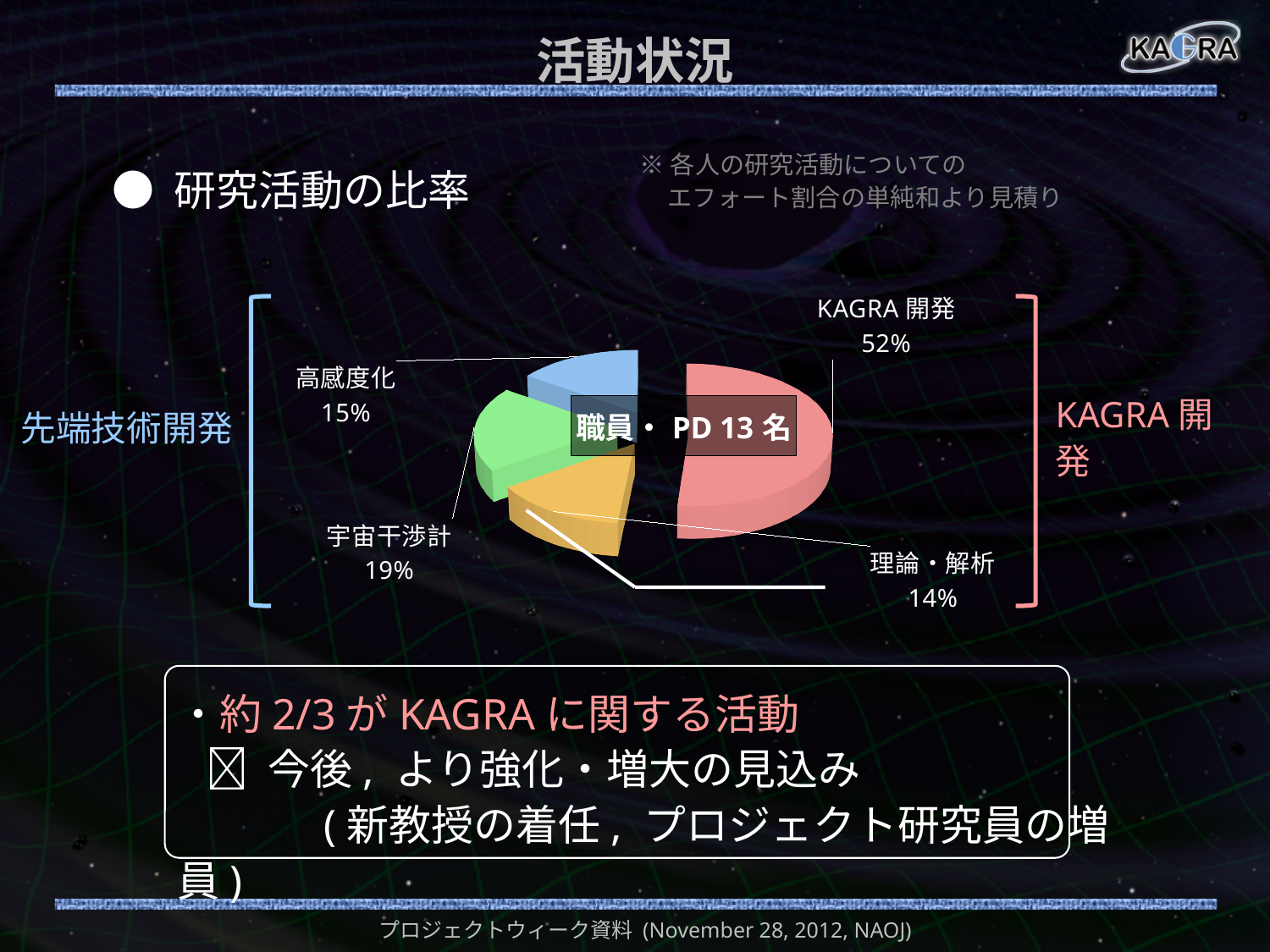
Which slice of the pie chart is the smallest? 理論・解析 What is the difference in percentage points between KAGRA 開発 and 宇宙干渉計? 33 What percentage is shown for 宇宙干渉計 in the pie chart? 19% What kind of chart is shown on the slide? pie chart What percentage is shown for 高感度化 in the pie chart? 15% Which slice of the pie chart is the largest? KAGRA 開発 How many slices does the pie chart have? 4 What text is written in the label box at the centre of the pie chart? 職員・PD 13 名 Which is larger in the pie chart, 宇宙干渉計 or 高感度化? 宇宙干渉計 What is the combined share of the two slices grouped under the 先端技術開発 bracket (高感度化 and 宇宙干渉計)? 34% What percentage is shown for 理論・解析 in the pie chart? 14% What percentage is shown for KAGRA 開発 in the pie chart? 52%